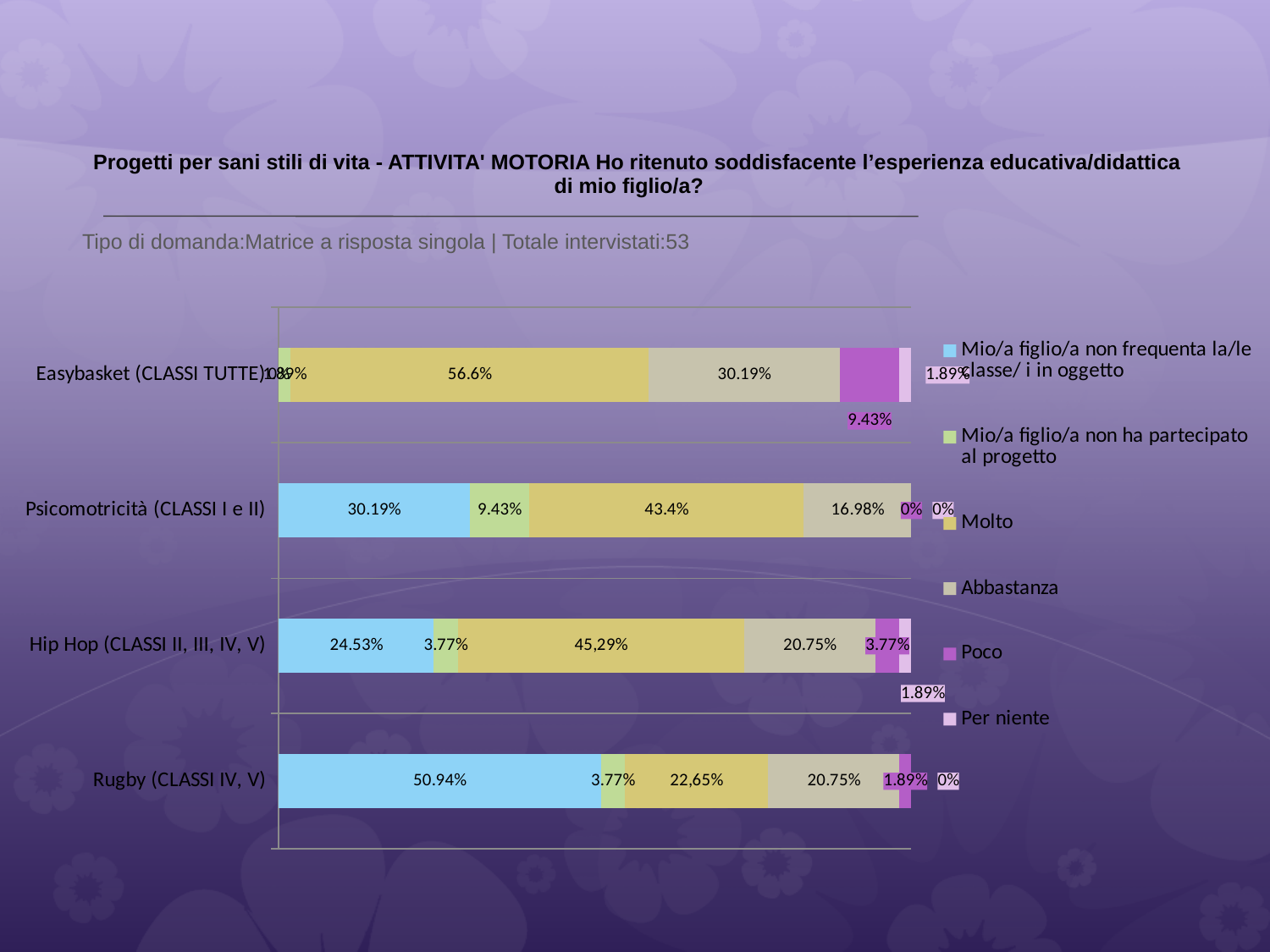
What kind of chart is shown on the slide? Stacked bar chart What is the 'Molto' value for Easybasket (CLASSI TUTTE)? 56.6% Which has the larger 'Molto' value, Hip Hop (CLASSI II, III, IV, V) or Rugby (CLASSI IV, V)? Hip Hop (CLASSI II, III, IV, V) Which category has the highest 'Molto' value? Easybasket (CLASSI TUTTE) How many series does the legend list? 6 What is the 'Poco' value for Easybasket (CLASSI TUTTE)? 9.43% What is the 'Molto' value for Rugby (CLASSI IV, V)? 22,65% What is the 'Abbastanza' value for Psicomotricità (CLASSI I e II)? 16.98% Which category has the highest 'Mio/a figlio/a non frequenta la/le classe/i in oggetto' value? Rugby (CLASSI IV, V) What is the 'Mio/a figlio/a non frequenta la/le classe/i in oggetto' value for Rugby (CLASSI IV, V)? 50.94% What is the difference between the 'Abbastanza' values for Easybasket (CLASSI TUTTE) and Hip Hop (CLASSI II, III, IV, V)? 9.44% How many project categories are shown on the chart? 4